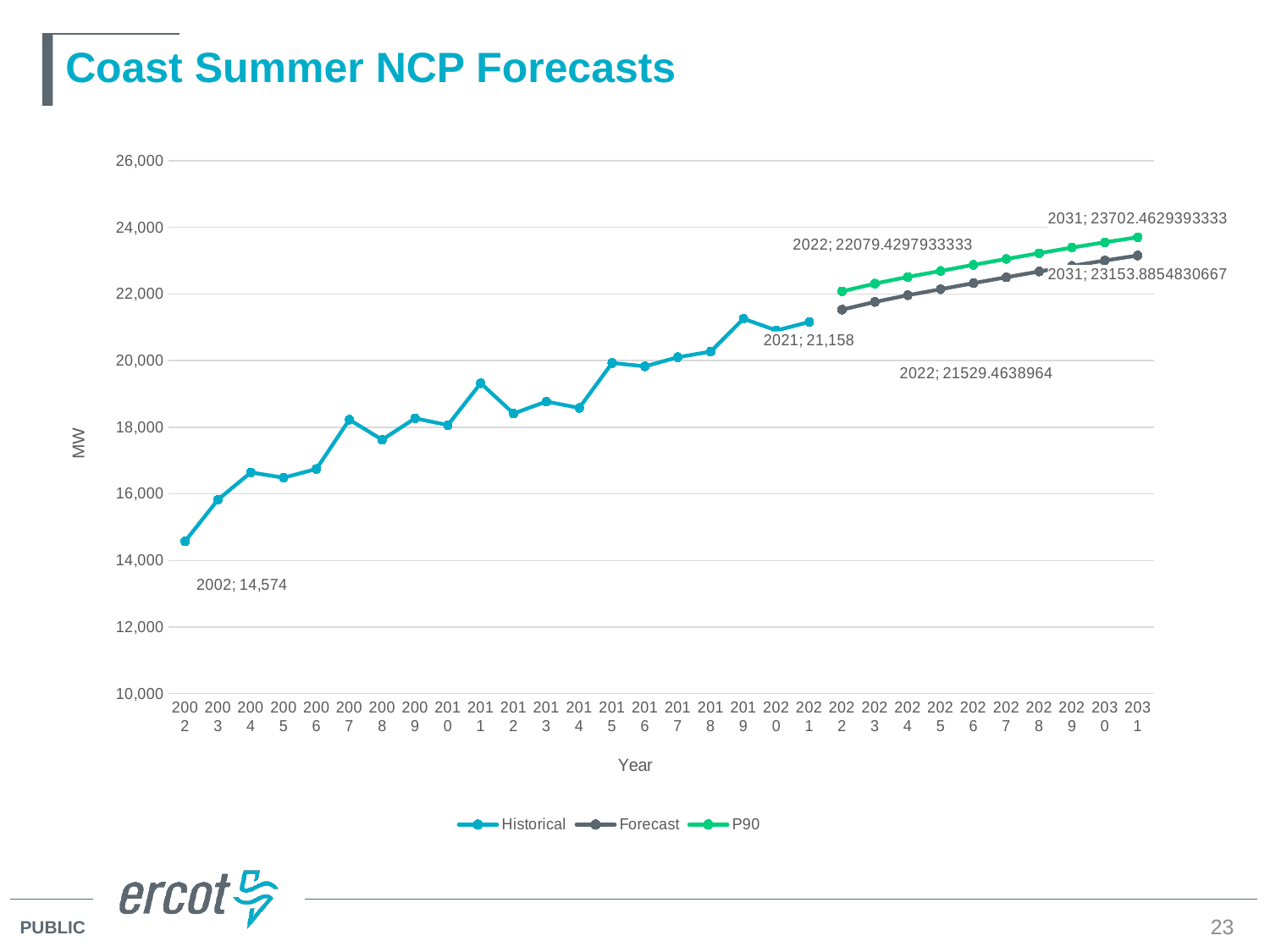
Is the Historical value for 2008 greater or less than 18,000? less In 2031, which series has the larger value, P90 or Forecast? P90 What is the Historical value for 2002? 14,574 Is the Historical value for 2019 greater or less than 20,000? greater What is the P90 value for 2031? 23702.4629393333 What kind of chart is shown on the slide? Line chart What is the Forecast value for 2031? 23153.8854830667 What is the Historical value for 2021? 21,158 What is the Forecast value for 2022? 21529.4638964 How many series does the legend list? 3 How much higher is the Historical value in 2021 than in 2002? 6,584 What is the P90 value for 2022? 22079.4297933333